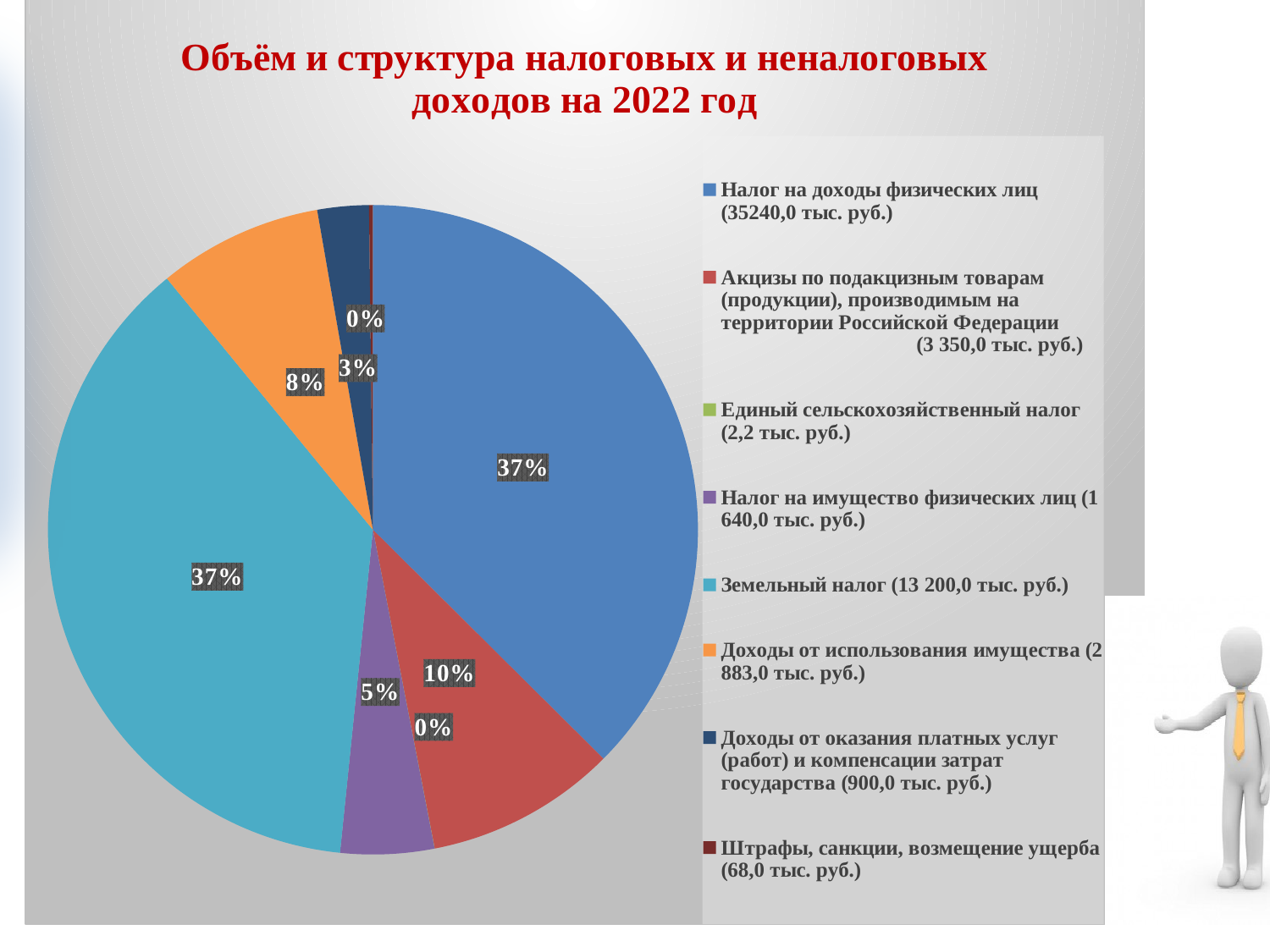
What percentage is shown for "Налог на имущество физических лиц"? 5% What percentage is shown for "Доходы от оказания платных услуг (работ) и компенсации затрат государства"? 3% By how many percentage points does the "Акцизы по подакцизным товарам" slice exceed the "Налог на имущество физических лиц" slice? 5 percentage points What kind of chart is shown on the slide? Pie chart What share of the pie does "Земельный налог" account for? 37% How many categories does the legend of the pie chart list? 8 What amount does the legend give for "Земельный налог"? 13 200,0 тыс. руб. What share of the pie is "Доходы от использования имущества"? 8% Which slice is larger: "Доходы от использования имущества" or "Доходы от оказания платных услуг (работ) и компенсации затрат государства"? Доходы от использования имущества What is the title of the chart on the slide? Объём и структура налоговых и неналоговых доходов на 2022 год What percentage is shown for "Акцизы по подакцизным товарам (продукции), производимым на территории Российской Федерации"? 10% Which slice is larger: "Акцизы по подакцизным товарам" or "Налог на имущество физических лиц"? Акцизы по подакцизным товарам